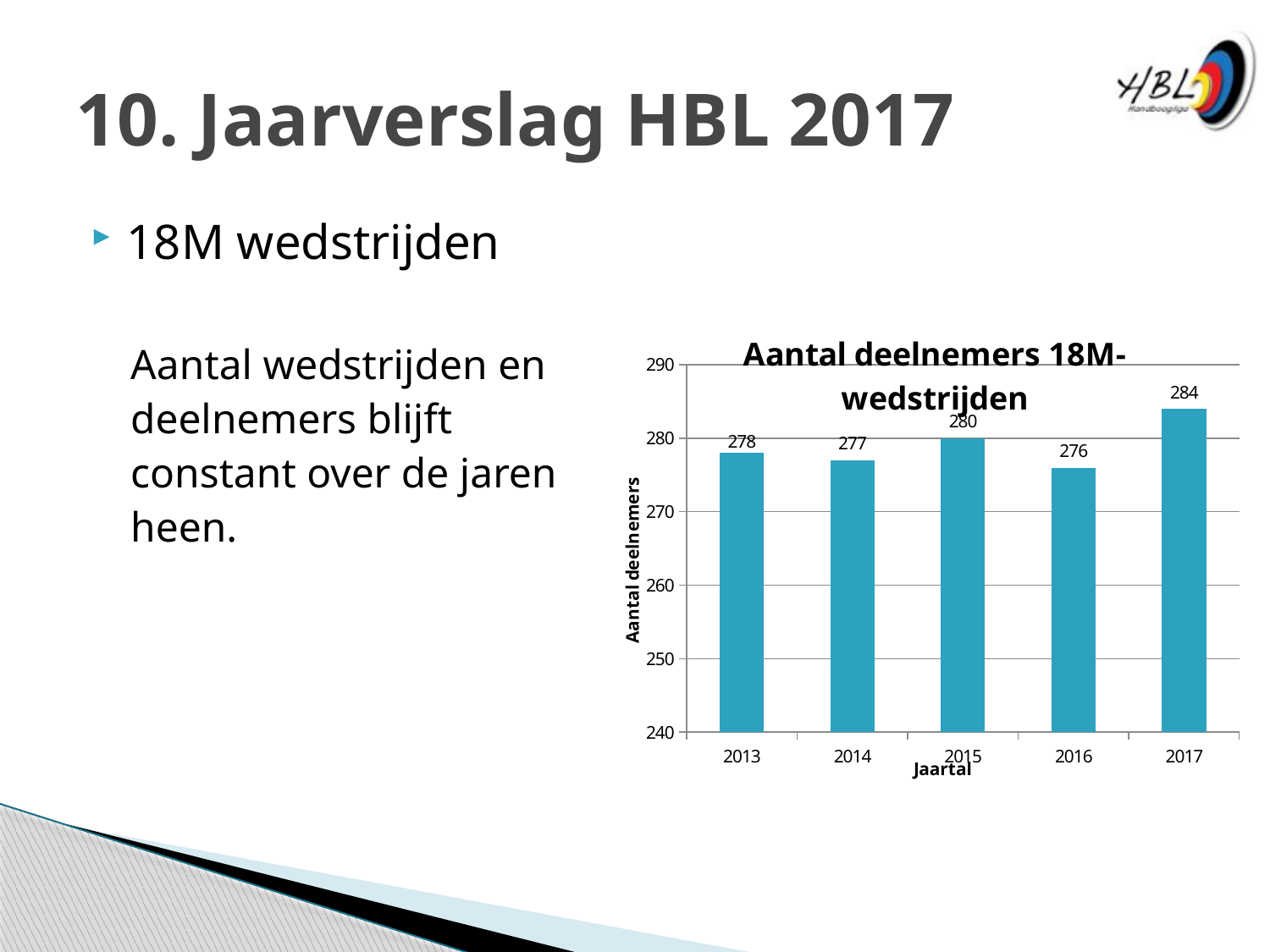
What is the difference in participants between 2017 and 2016? 8 What is the number of participants in 2016? 276 What is the title of the chart? Aantal deelnemers 18M-wedstrijden What is the label of the x axis? Jaartal Which year has the lowest number of participants? 2016 How many years are shown on the x axis? 5 What kind of chart is shown on the slide? bar chart Which year had more participants, 2015 or 2014? 2015 Which year has the highest number of participants? 2017 Is the value for 2017 greater or less than 280? greater What is the number of participants in 2017? 284 What is the number of participants in 2013? 278